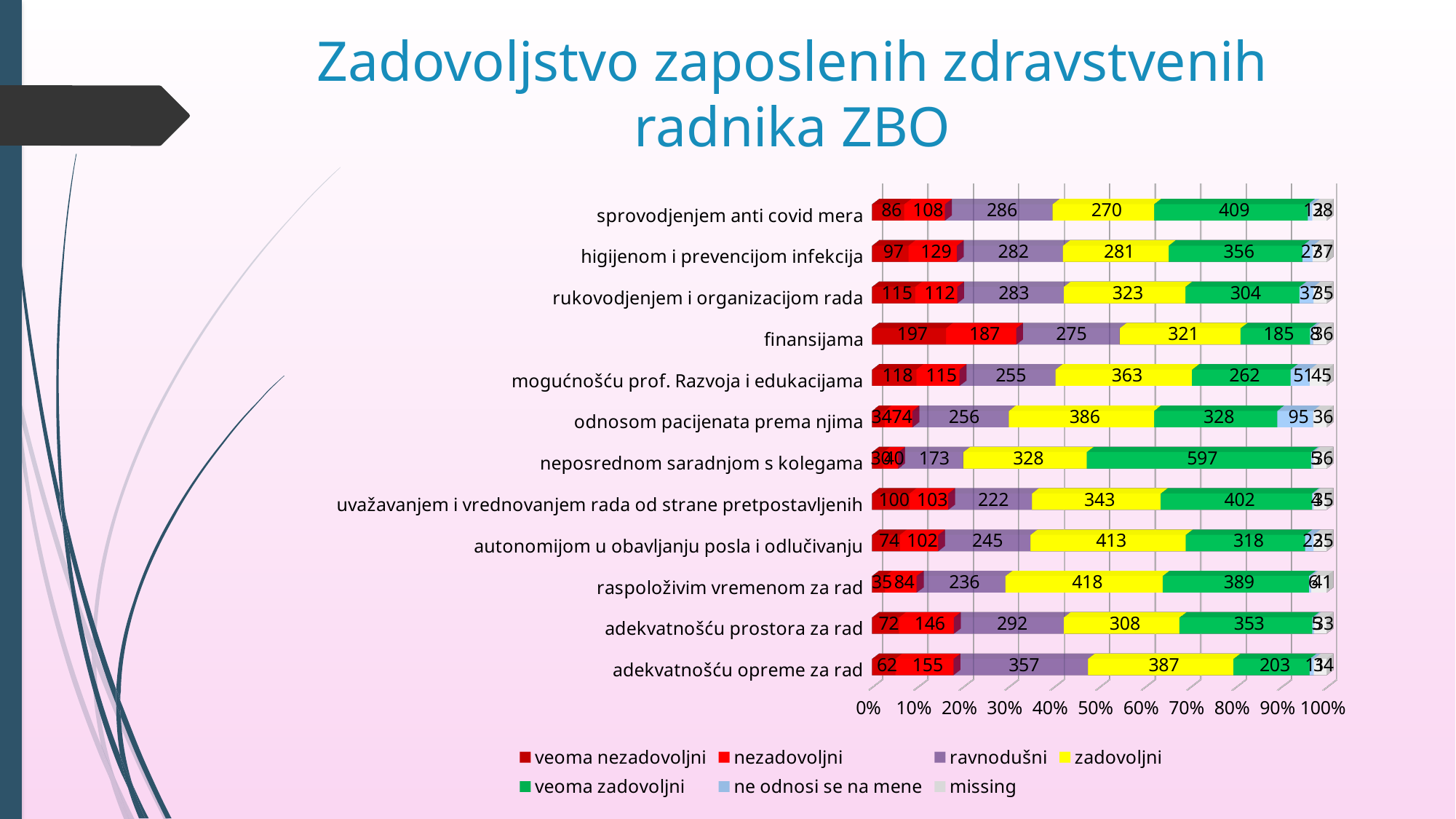
Which is larger: the 'nezadovoljni' value for 'adekvatnošću opreme za rad' or for 'adekvatnošću prostora za rad'? adekvatnošću opreme za rad What is the value of the 'veoma zadovoljni' segment for 'neposrednom saradnjom s kolegama'? 597 What is the value of the 'veoma nezadovoljni' segment for 'finansijama'? 197 Which category has the highest 'veoma zadovoljni' value? neposrednom saradnjom s kolegama Which category has the lowest 'veoma zadovoljni' value? finansijama How many categories (rows) does the chart show? 12 What is the value of the 'ravnodušni' segment for 'adekvatnošću opreme za rad'? 357 How many series does the legend list? 7 What is the difference between the 'zadovoljni' values for 'autonomijom u obavljanju posla i odlučivanju' (413) and 'sprovodjenjem anti covid mera' (270)? 143 What colour represents the 'zadovoljni' series in the legend? yellow What kind of chart is shown on the slide? stacked bar chart What is the value of the 'zadovoljni' segment for 'raspoloživim vremenom za rad'? 418